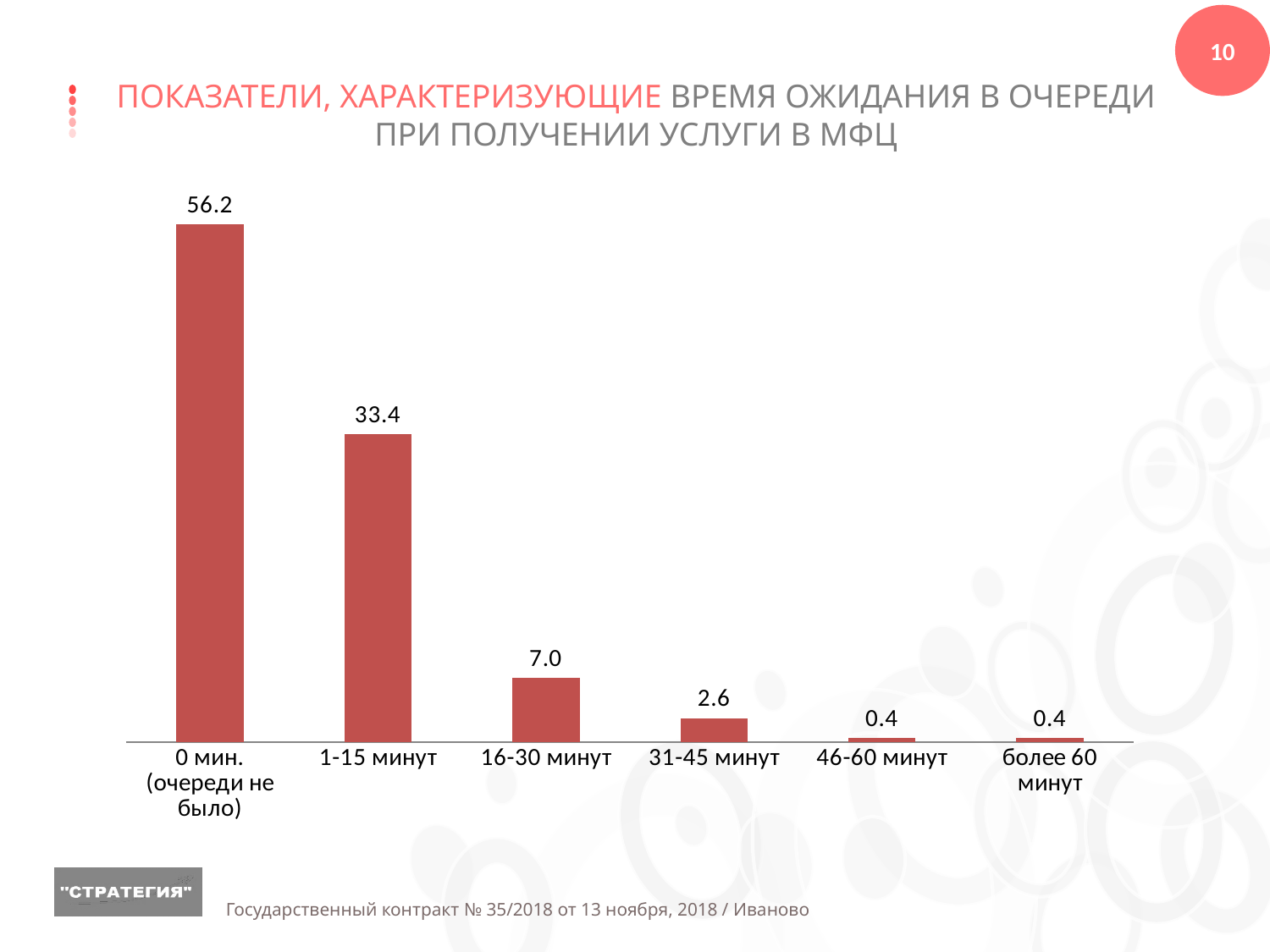
What kind of chart is shown on the slide? bar chart What is the value for the '1-15 минут' category? 33.4 What is the value for the '31-45 минут' category? 2.6 What is the difference between the values for '0 мин. (очереди не было)' and '1-15 минут'? 22.8 Do the values rise or fall from left to right along the x axis? fall Which is larger, the value for '1-15 минут' or the value for '16-30 минут'? 1-15 минут What is the difference between the values for '16-30 минут' and '31-45 минут'? 4.4 How many categories are shown on the x axis? 6 Which category has the highest value? 0 мин. (очереди не было) What colour are the bars in the chart? red What is the value for the '46-60 минут' category? 0.4 What is the value for the '16-30 минут' category? 7.0